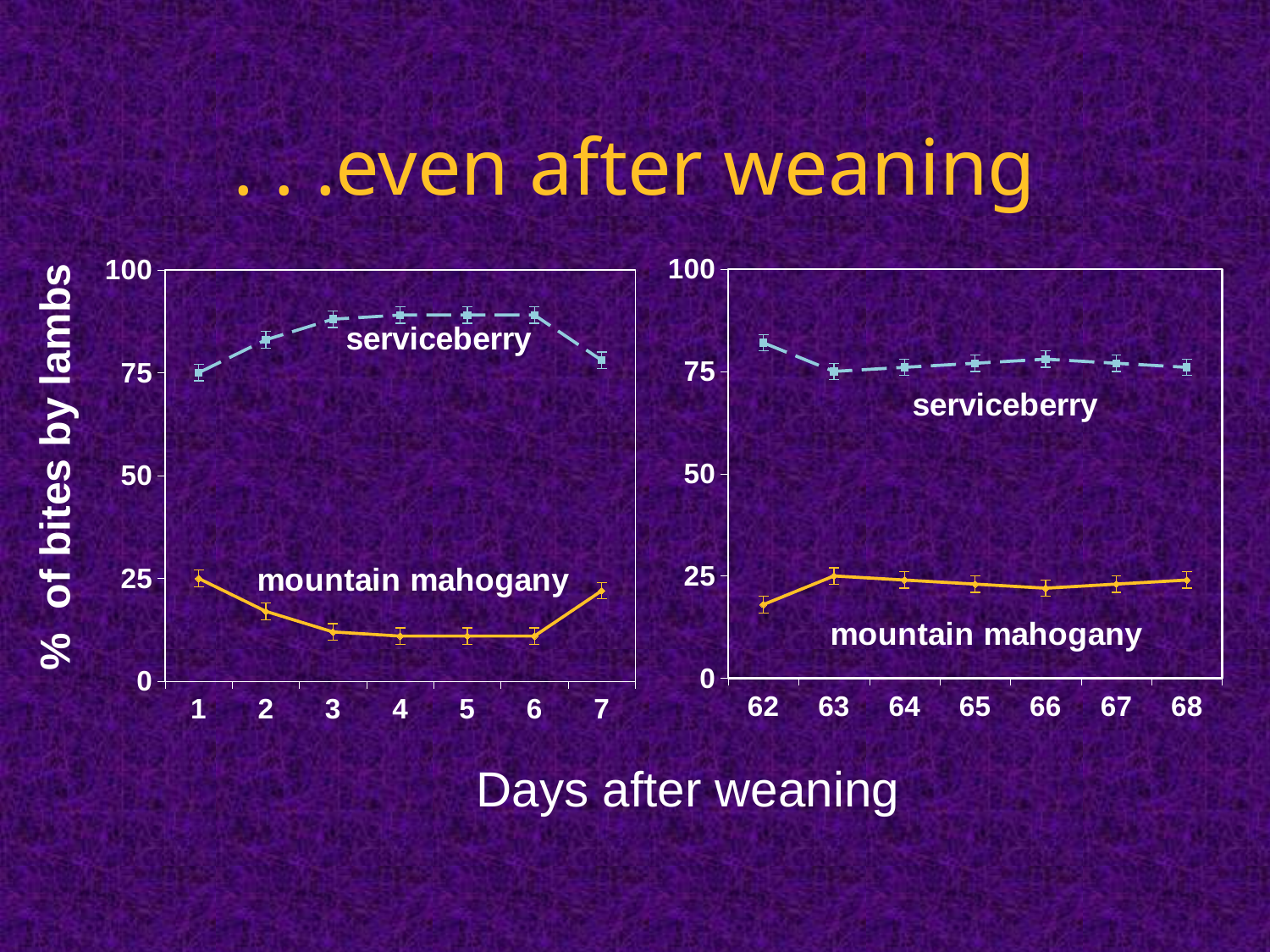
What is the label of the shared x axis below the two charts? Days after weaning On the left chart (days 1 to 7), which series has the higher value on day 3, serviceberry or mountain mahogany? serviceberry On the left chart (days 1 to 7), is the value for serviceberry on day 4 greater or less than 75? greater How many days are plotted on the x axis of the left chart (days 1 to 7)? 7 On the right chart (days 62 to 68), on which day is the mountain mahogany value lowest? 62 On the right chart (days 62 to 68), is the value for mountain mahogany on day 62 greater or less than 25? less What kind of chart is the left chart (days 1 to 7)? line chart On the right chart (days 62 to 68), is the value for serviceberry on day 62 greater or less than 75? greater On the left chart (days 1 to 7), does the mountain mahogany value rise or fall from day 1 to day 4? fall On the right chart (days 62 to 68), on which day is the serviceberry value highest? 62 How many series are plotted on the right chart (days 62 to 68)? 2